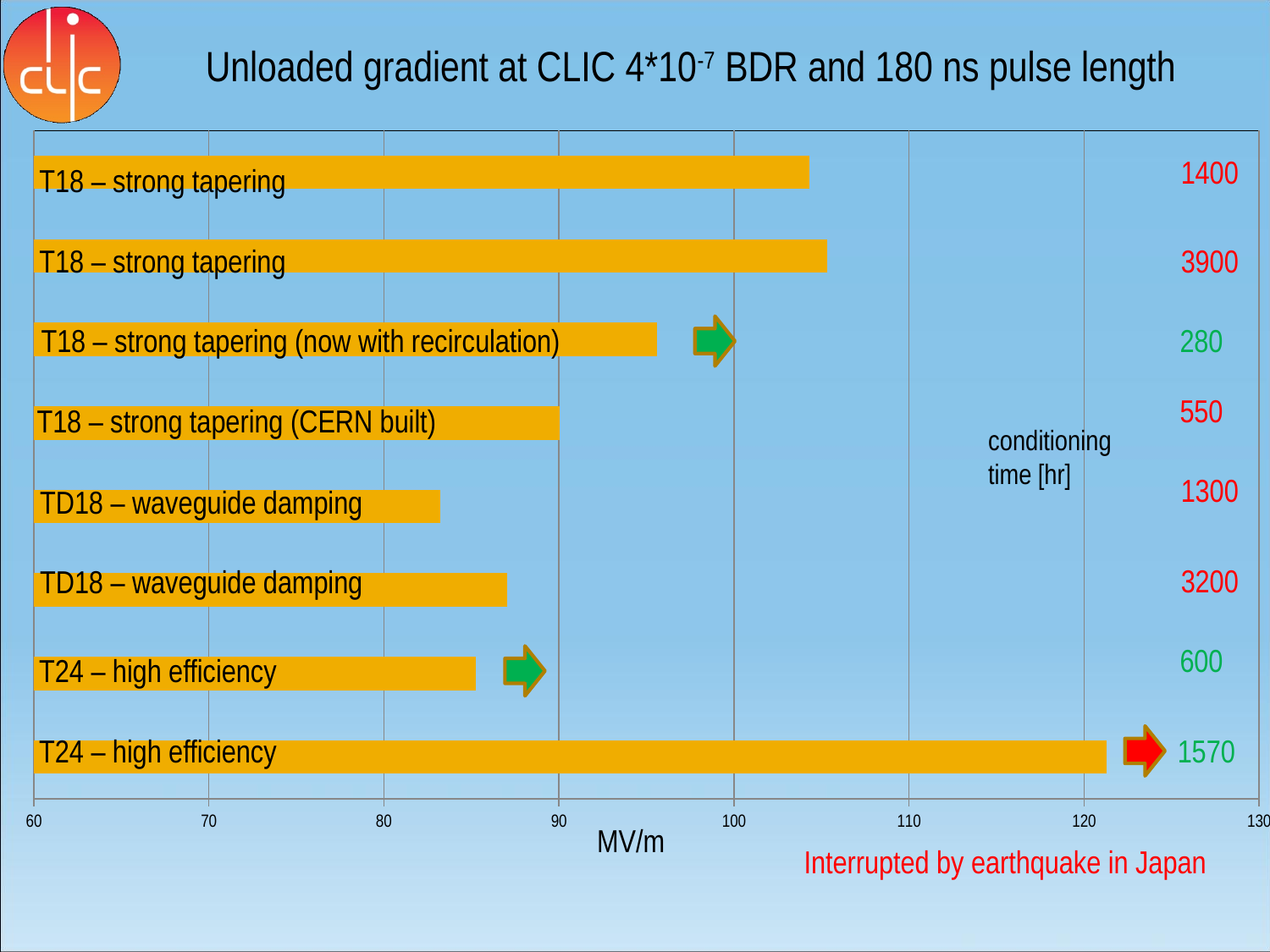
Is the value for T18 – strong tapering (now with recirculation) greater or less than 90 MV/m? greater What conditioning time in hours is printed next to the bottom T24 – high efficiency bar? 1570 Is the value for the topmost T18 – strong tapering bar greater or less than 100 MV/m? greater How many bars are plotted in the chart? 8 Is the value for the bottom T24 – high efficiency bar greater or less than 110 MV/m? greater What unit is shown on the x axis of the chart? MV/m Which is larger: the value for T18 – strong tapering (now with recirculation) or T18 – strong tapering (CERN built)? T18 – strong tapering (now with recirculation) Which category has the highest unloaded gradient in the chart? T24 – high efficiency (bottom bar) Which is larger: the upper TD18 – waveguide damping bar or the lower TD18 – waveguide damping bar? the lower TD18 – waveguide damping bar What kind of chart is shown on the slide? bar chart